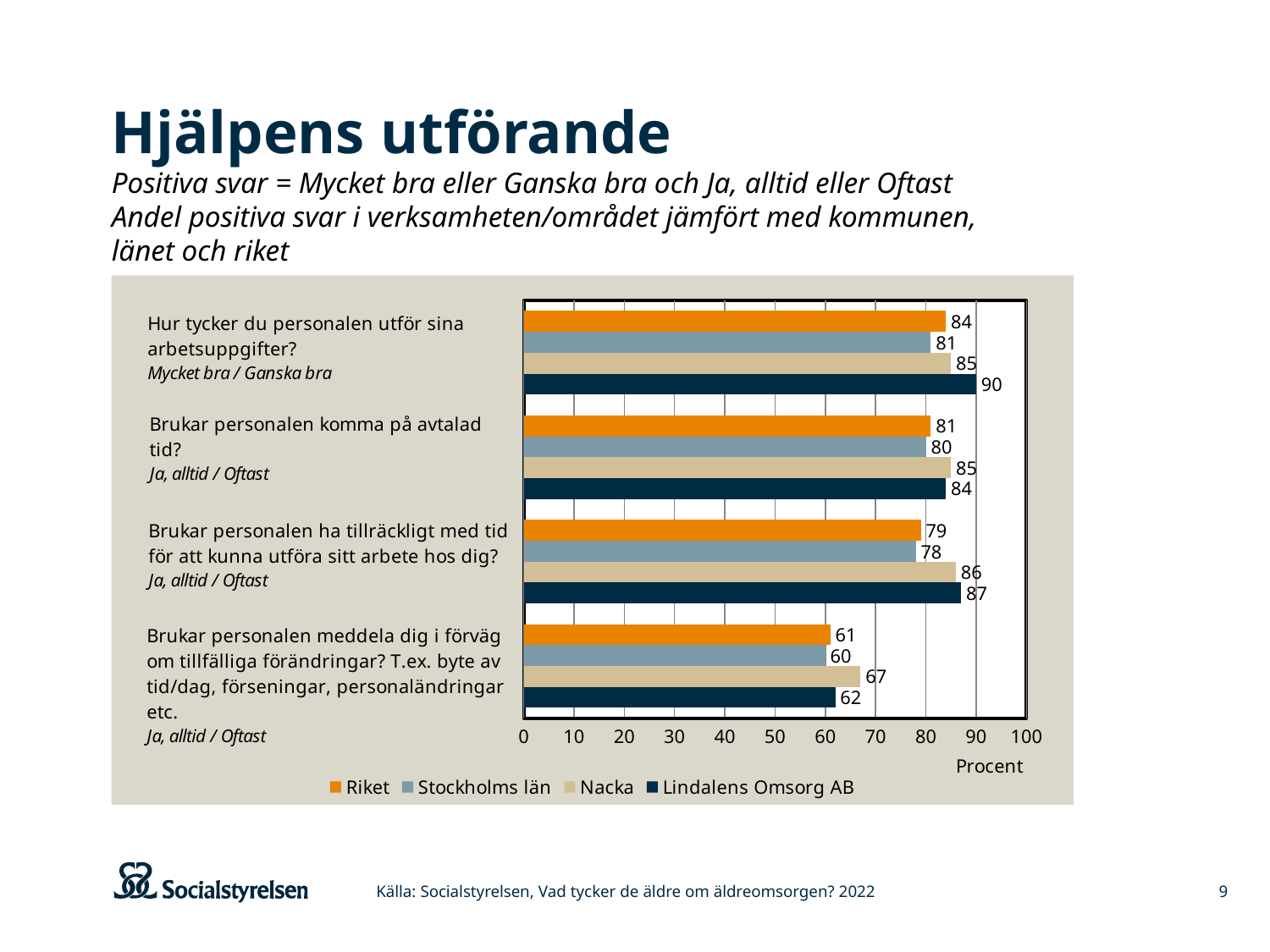
What is the value for Riket for the question "Brukar personalen komma på avtalad tid?"? 81 What is the difference between Lindalens Omsorg AB and Riket for the question "Brukar personalen ha tillräckligt med tid för att kunna utföra sitt arbete hos dig?"? 8 Which is larger for the question "Brukar personalen meddela dig i förväg om tillfälliga förändringar?": Nacka or Lindalens Omsorg AB? Nacka Which series has the highest value for the question "Hur tycker du personalen utför sina arbetsuppgifter?"? Lindalens Omsorg AB What is the value for Nacka for the question "Brukar personalen ha tillräckligt med tid för att kunna utföra sitt arbete hos dig?"? 86 What is the label on the horizontal axis of the chart? Procent Which series has the lowest value for the question "Brukar personalen meddela dig i förväg om tillfälliga förändringar?"? Stockholms län What is the value for Lindalens Omsorg AB for the question "Hur tycker du personalen utför sina arbetsuppgifter?"? 90 How many series does the legend list? 4 What type of chart is shown on the slide? Bar chart How many question categories are shown on the chart? 4 What is the value for Stockholms län for the question "Brukar personalen meddela dig i förväg om tillfälliga förändringar?"? 60